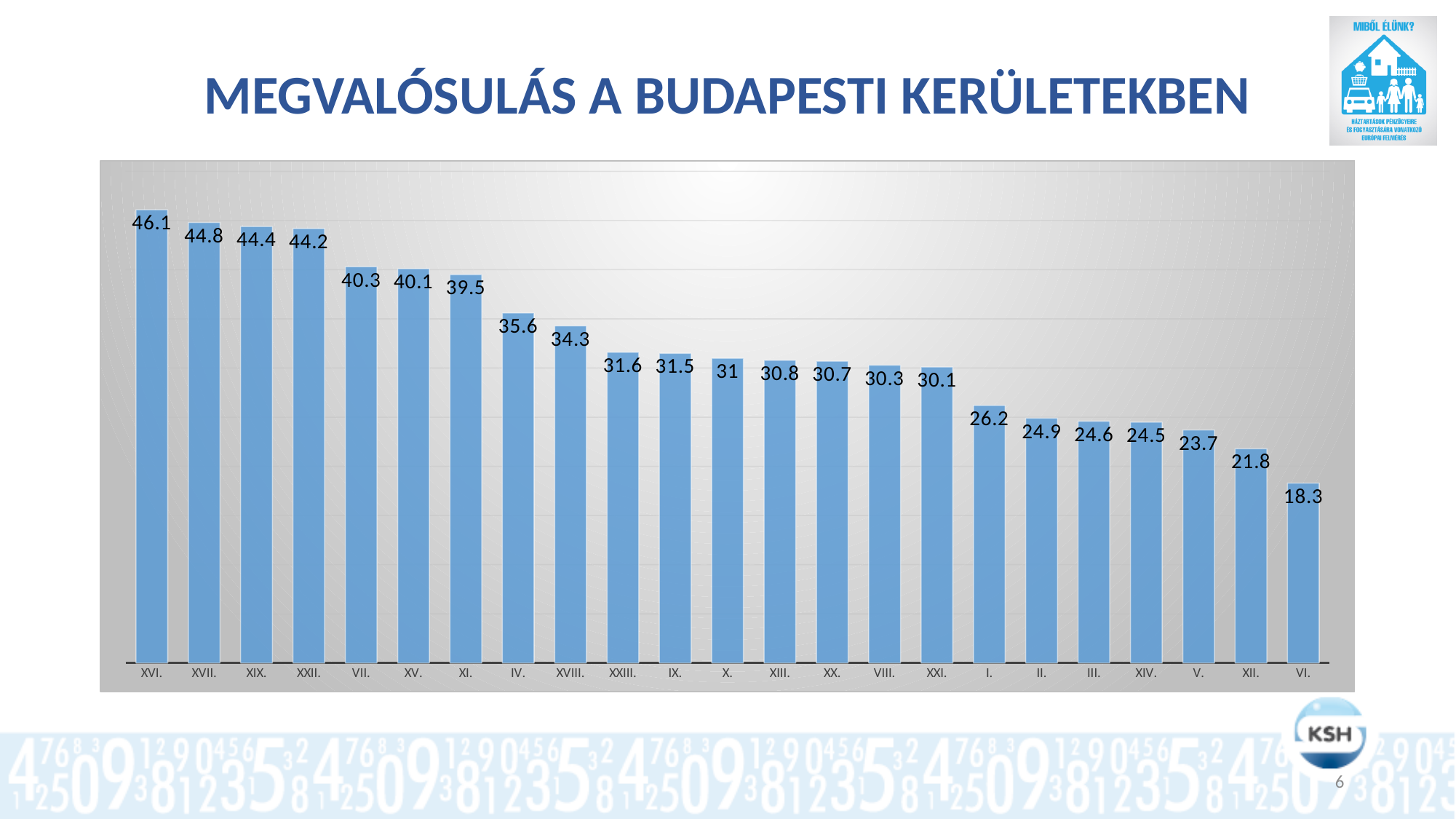
What is the difference between the values for district VII. and district XI.? 0.8 How many districts are shown in the chart? 23 Which has a larger value, district XVIII. or district XXI.? XVIII. Do the values rise or fall from left to right along the x axis? Fall What is the value for district XVI.? 46.1 What is the value for district IV.? 35.6 What is the value for district VI.? 18.3 Which district has the lowest value? VI. What kind of chart is shown on the slide? Bar chart Which district has the highest value? XVI. What is the difference between the values for district XVI. and district VI.? 27.8 What is the value for district I.? 26.2